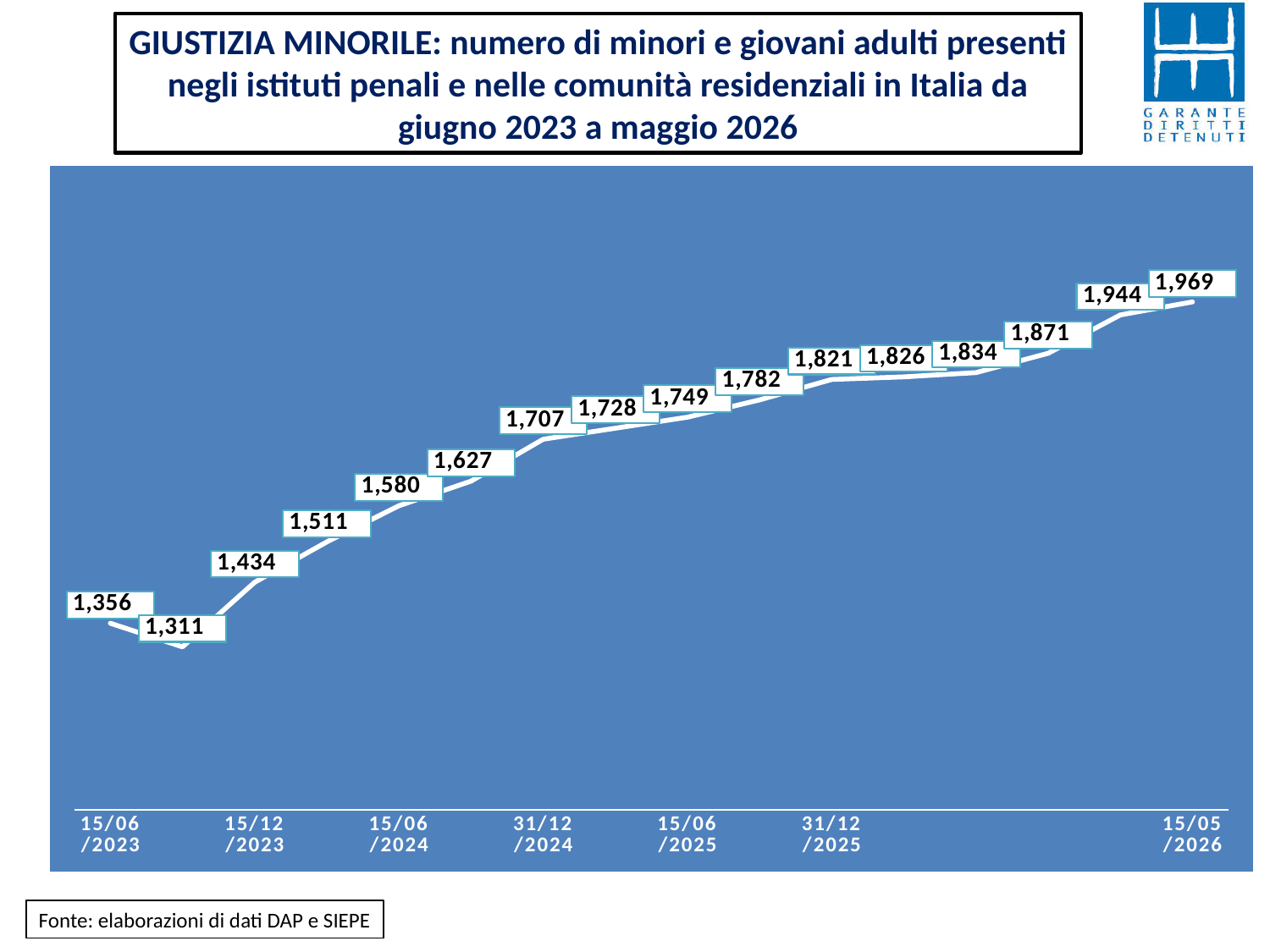
Do the values generally rise or fall from 15/06/2023 to 15/05/2026? rise What is the value at 15/05/2026? 1,969 How many data points are plotted on the line? 16 What is the value at 15/06/2023? 1,356 What kind of chart is shown on the slide? line chart What is the difference between the value at 15/05/2026 and the value at 15/06/2023? 613 Which is larger, the value at 15/06/2024 or the value at 15/06/2025? 15/06/2025 What is the highest value plotted on the chart? 1,969 What is the value at 15/12/2023? 1,434 What is the lowest value plotted on the chart? 1,311 What is the value at 31/12/2024? 1,707 What is the value at 31/12/2025? 1,821